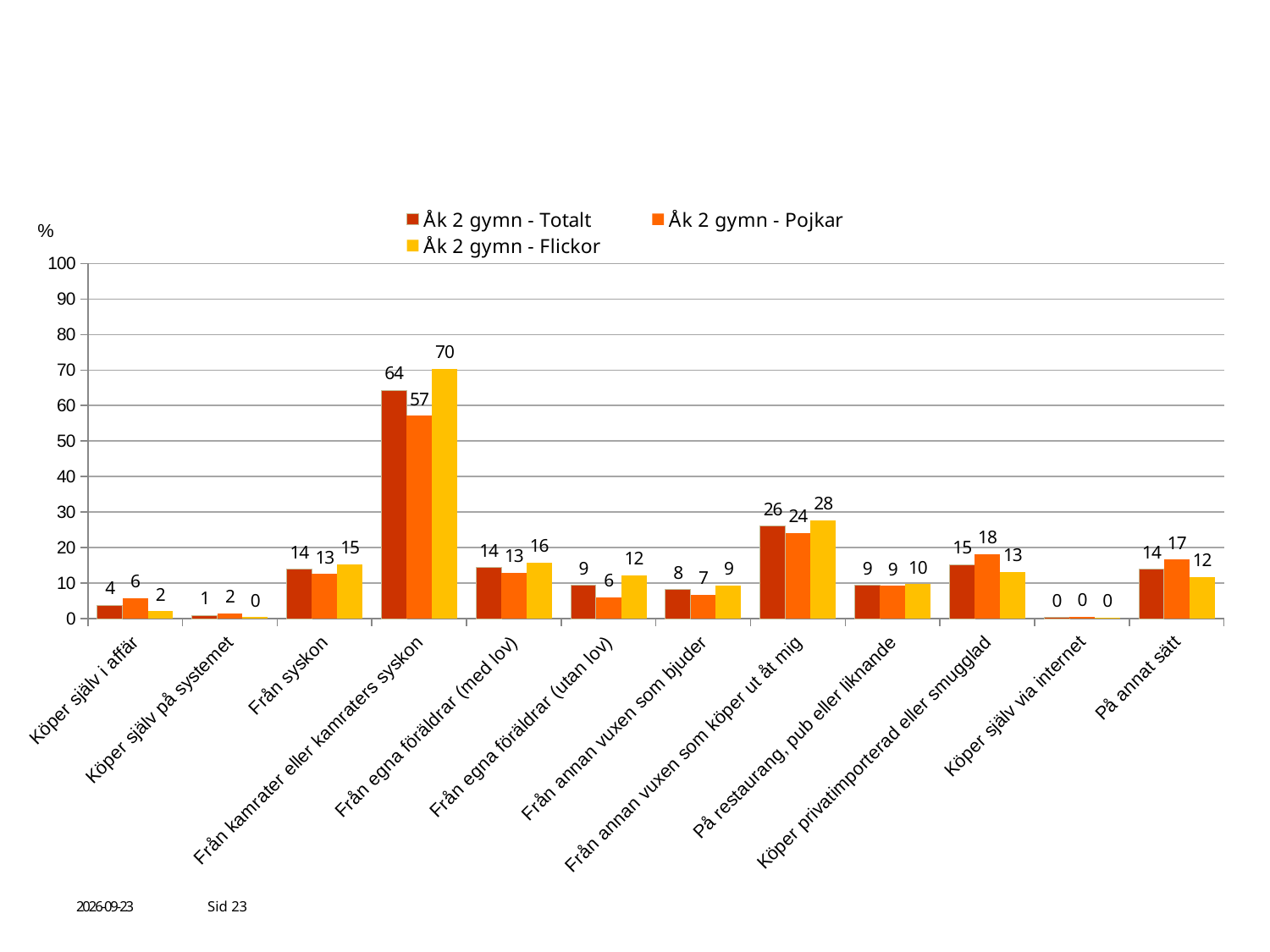
What is the value for "Åk 2 gymn - Flickor" in the category "Från kamrater eller kamraters syskon"? 70 What unit is shown on the y axis label? % How many categories are shown on the x axis? 12 What is the value for "Åk 2 gymn - Pojkar" in the category "Från annan vuxen som köper ut åt mig"? 24 How many series does the legend list? 3 In the category "På annat sätt", which is larger: the value for "Åk 2 gymn - Pojkar" or for "Åk 2 gymn - Flickor"? Åk 2 gymn - Pojkar Is the value for "Åk 2 gymn - Totalt" in the category "Från kamrater eller kamraters syskon" greater or less than 50? greater What is the difference between the "Åk 2 gymn - Flickor" and "Åk 2 gymn - Pojkar" values in the category "Från kamrater eller kamraters syskon"? 13 What kind of chart is shown on the slide? bar chart Which category has the highest value for "Åk 2 gymn - Totalt"? Från kamrater eller kamraters syskon What is the value for "Åk 2 gymn - Totalt" in the category "Köper privatimporterad eller smugglad"? 15 Which category has the lowest value for "Åk 2 gymn - Pojkar"? Köper själv via internet